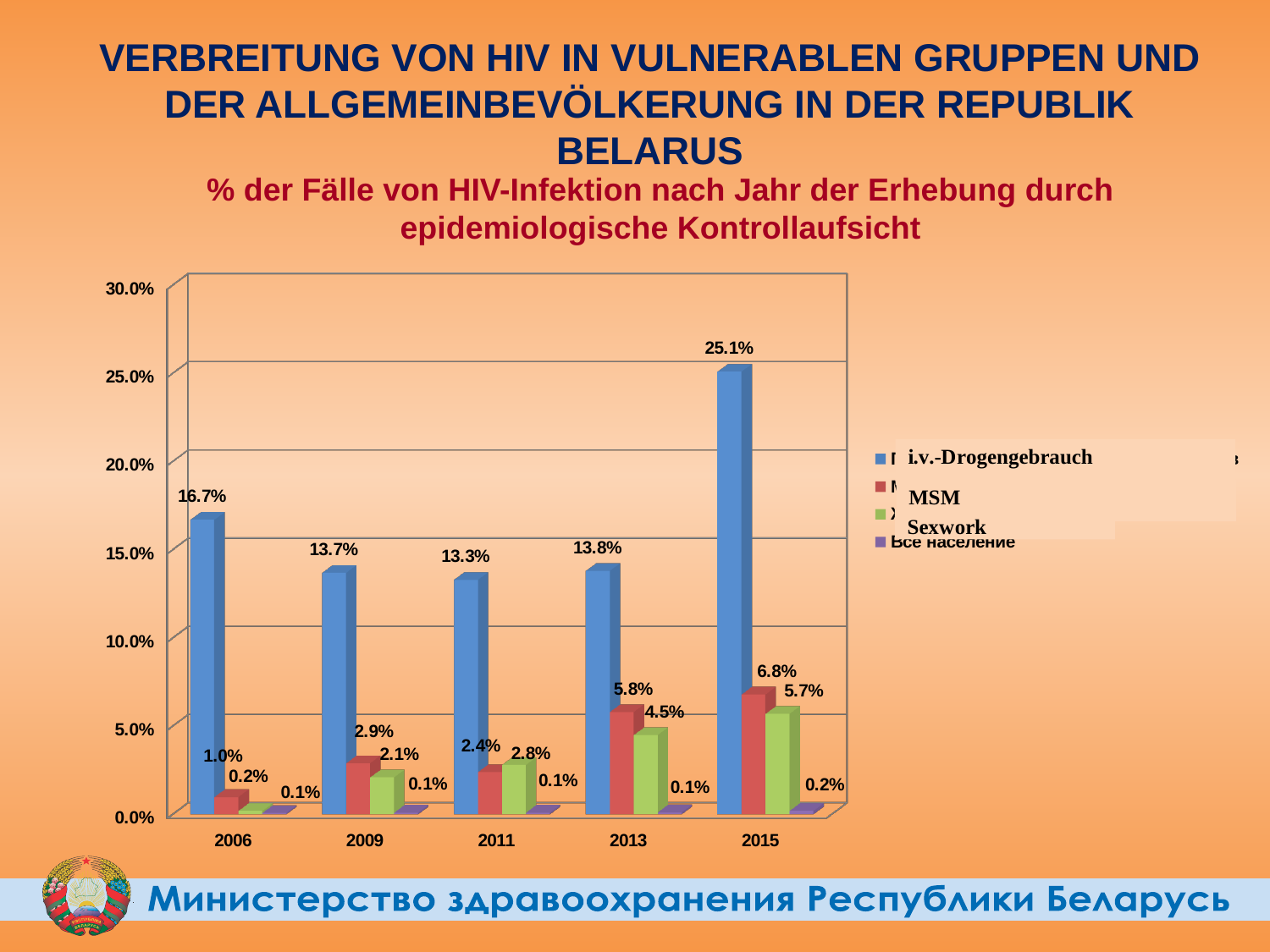
What kind of chart is shown on the slide? Bar chart In which year is the value for i.v.-Drogengebrauch lowest? 2011 What is the value for Sexwork in 2009? 2.1% How many years are shown on the x axis? 5 In which year is the value for i.v.-Drogengebrauch highest? 2015 How many series does the legend list? 4 What is the value for i.v.-Drogengebrauch in 2006? 16.7% Do the values for MSM rise or fall from 2006 to 2015? Rise Which is larger in 2011, the value for MSM or the value for Sexwork? Sexwork What is the value for i.v.-Drogengebrauch in 2015? 25.1% What is the value for MSM in 2013? 5.8% What is the difference between the i.v.-Drogengebrauch values in 2015 and 2013? 11.3%